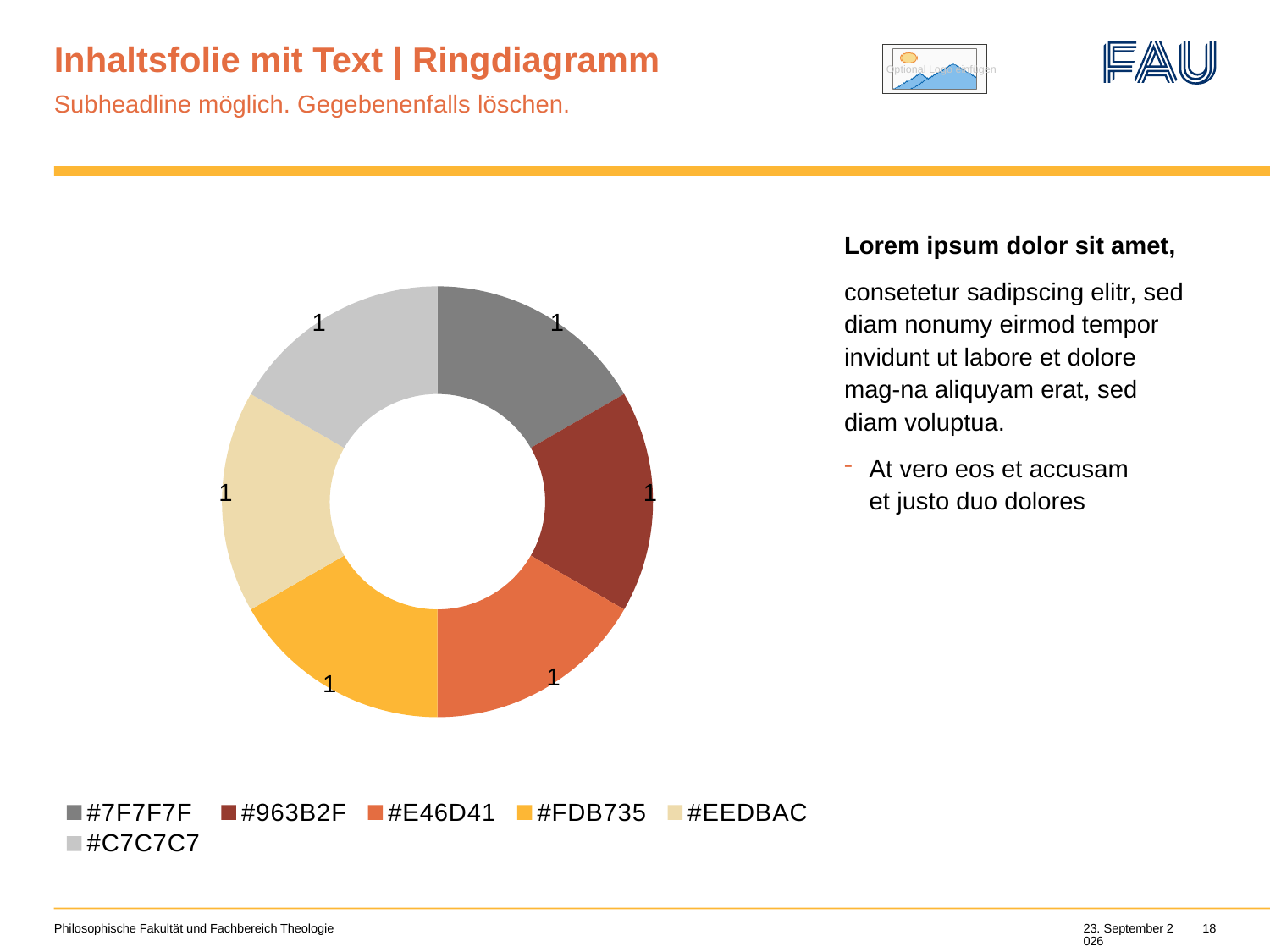
What kind of chart is shown on the slide? Doughnut chart What is the value of the #E46D41 slice in the doughnut chart? 1 What is the total of all slice values in the doughnut chart? 6 What is the value of the #EEDBAC slice in the doughnut chart? 1 How many slices does the doughnut chart have? 6 Which legend entry is listed first in the doughnut chart's legend? #7F7F7F How many entries does the legend of the doughnut chart list? 6 What is the value of the #C7C7C7 slice in the doughnut chart? 1 What is the value of the #7F7F7F slice in the doughnut chart? 1 What is the value of the #FDB735 slice in the doughnut chart? 1 What is the difference between the values of the #7F7F7F slice and the #FDB735 slice? 0 What is the value of the #963B2F slice in the doughnut chart? 1